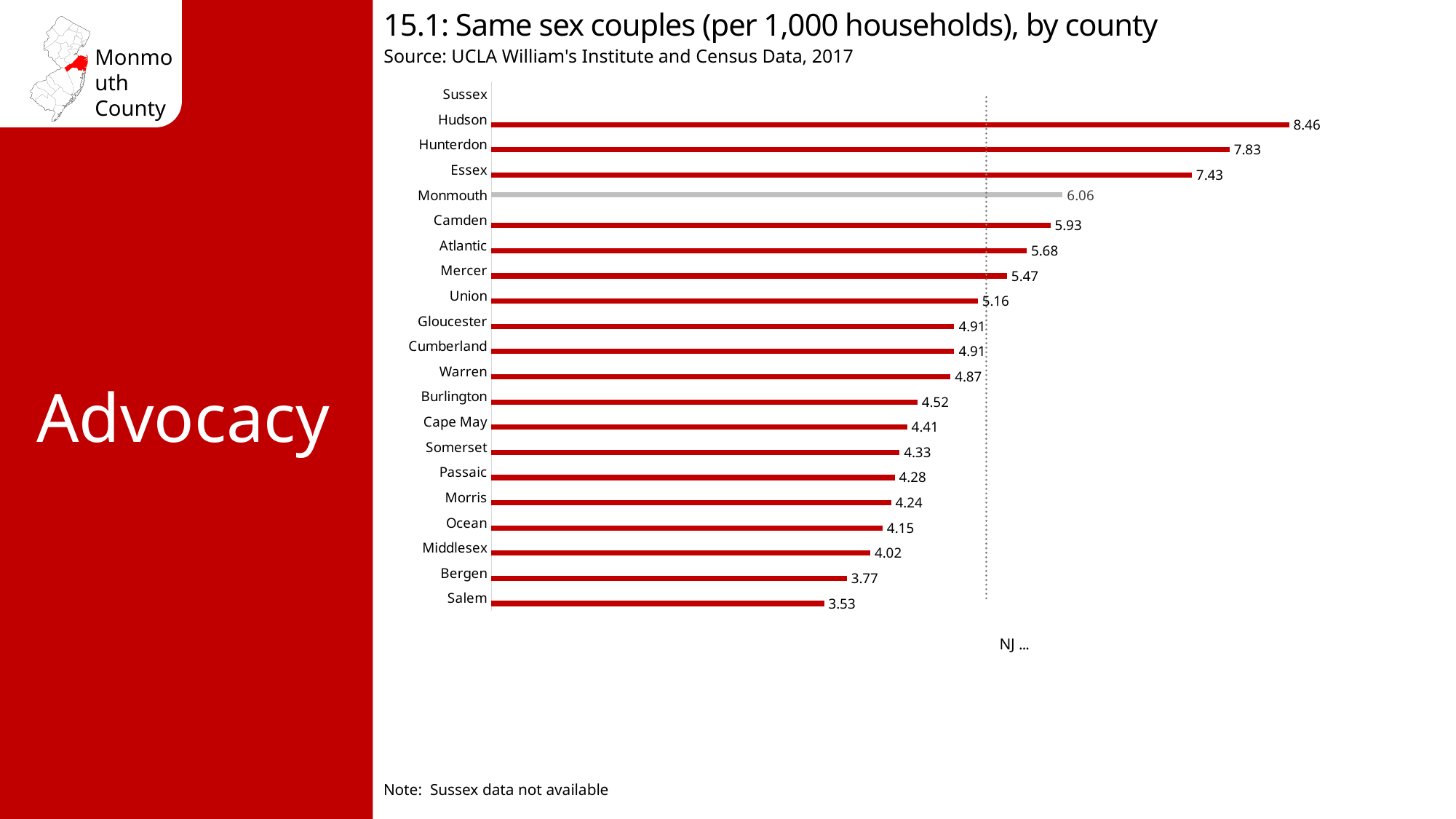
Which county has the highest value? Hudson What is the value for Hudson County? 8.46 Which has a larger value, Bergen or Middlesex? Middlesex What kind of chart is shown on the slide? Bar chart What is the value for Monmouth County? 6.06 Which has a larger value, Essex or Camden? Essex What is the value for Camden County? 5.93 Which county has the lowest plotted value? Salem What is the difference between the values for Monmouth and Salem? 2.53 What is the value for Salem County? 3.53 Which county is noted as having no data available? Sussex What is the difference between the values for Hudson and Hunterdon? 0.63